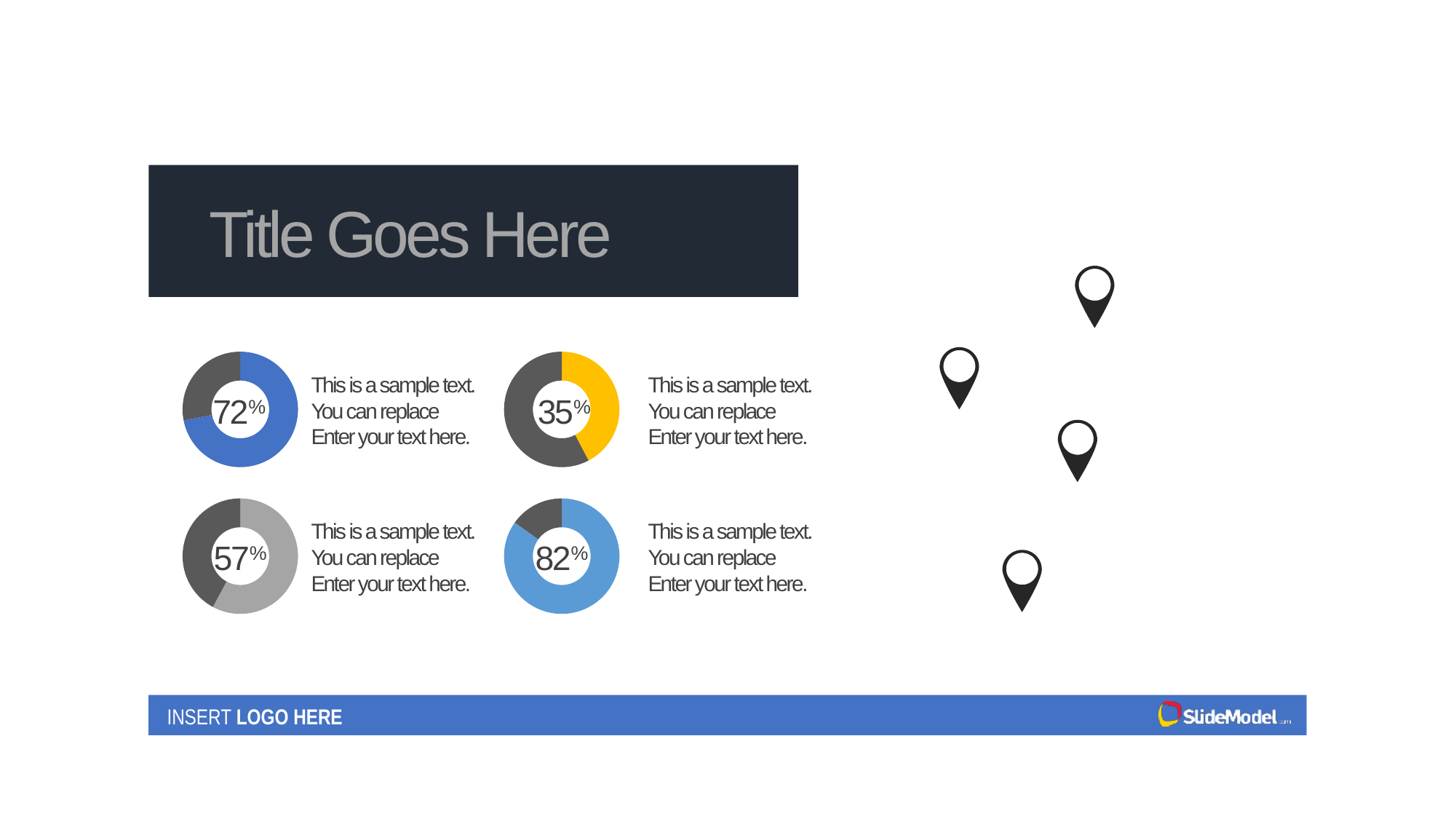
Which of the four donut charts shows the highest percentage? The bottom-right chart (82%) What colour is the filled portion of the top-right donut chart? Yellow How many donut charts are on the slide? 4 What kind of chart is used to display the percentages on the slide? Donut chart What value is shown in the top-left donut chart? 72% What value is shown in the bottom-right donut chart? 82% Which of the four donut charts shows the lowest percentage? The top-right chart (35%) What value is shown in the bottom-left donut chart? 57% What value is shown in the top-right donut chart? 35% Which is larger, the value in the top-left donut chart or the value in the bottom-left donut chart? The top-left chart (72%) What is the difference between the value in the bottom-right donut chart and the value in the top-right donut chart? 47% What is the difference between the value in the top-left donut chart and the value in the bottom-left donut chart? 15%